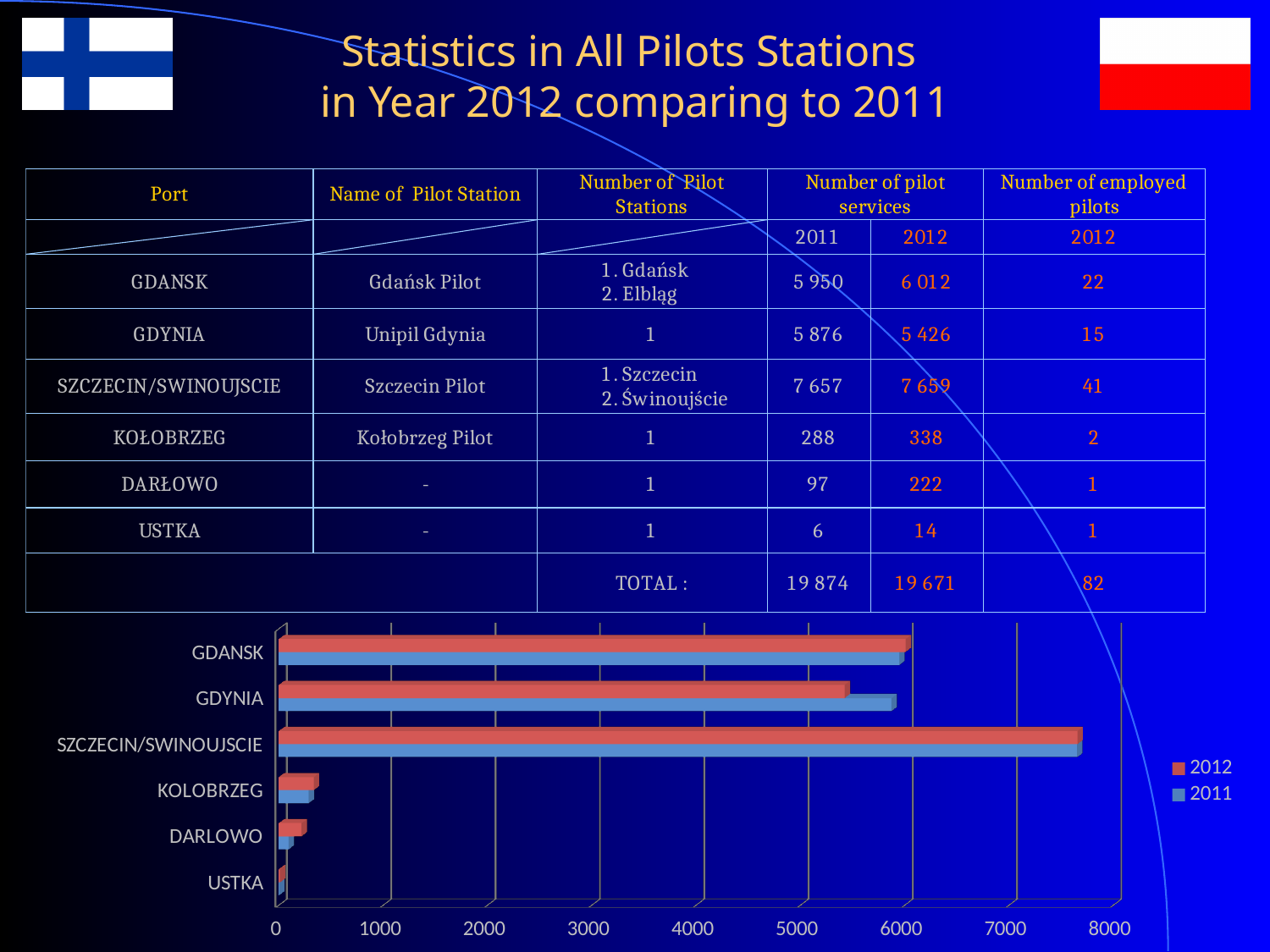
What kind of chart is shown at the bottom of the slide? bar chart In the bar chart, is the 2012 value for GDANSK greater or less than 5000? greater Which colour represents the 2012 series in the bar chart's legend? red How many ports are listed as categories on the bar chart? 6 For DARLOWO, which year has the larger bar in the chart, 2011 or 2012? 2012 Which port has the shortest bars in the bar chart? USTKA In the bar chart, is the 2012 value for SZCZECIN/SWINOUJSCIE greater or less than 7000? greater Which port has the longest bar for 2012 in the bar chart? SZCZECIN/SWINOUJSCIE For GDYNIA, which year has the larger bar in the chart, 2011 or 2012? 2011 According to the table, what is the number of pilot services for KOŁOBRZEG in 2012? 338 In the bar chart, is the 2012 value for GDYNIA greater or less than 6000? less How many series does the bar chart's legend list? 2